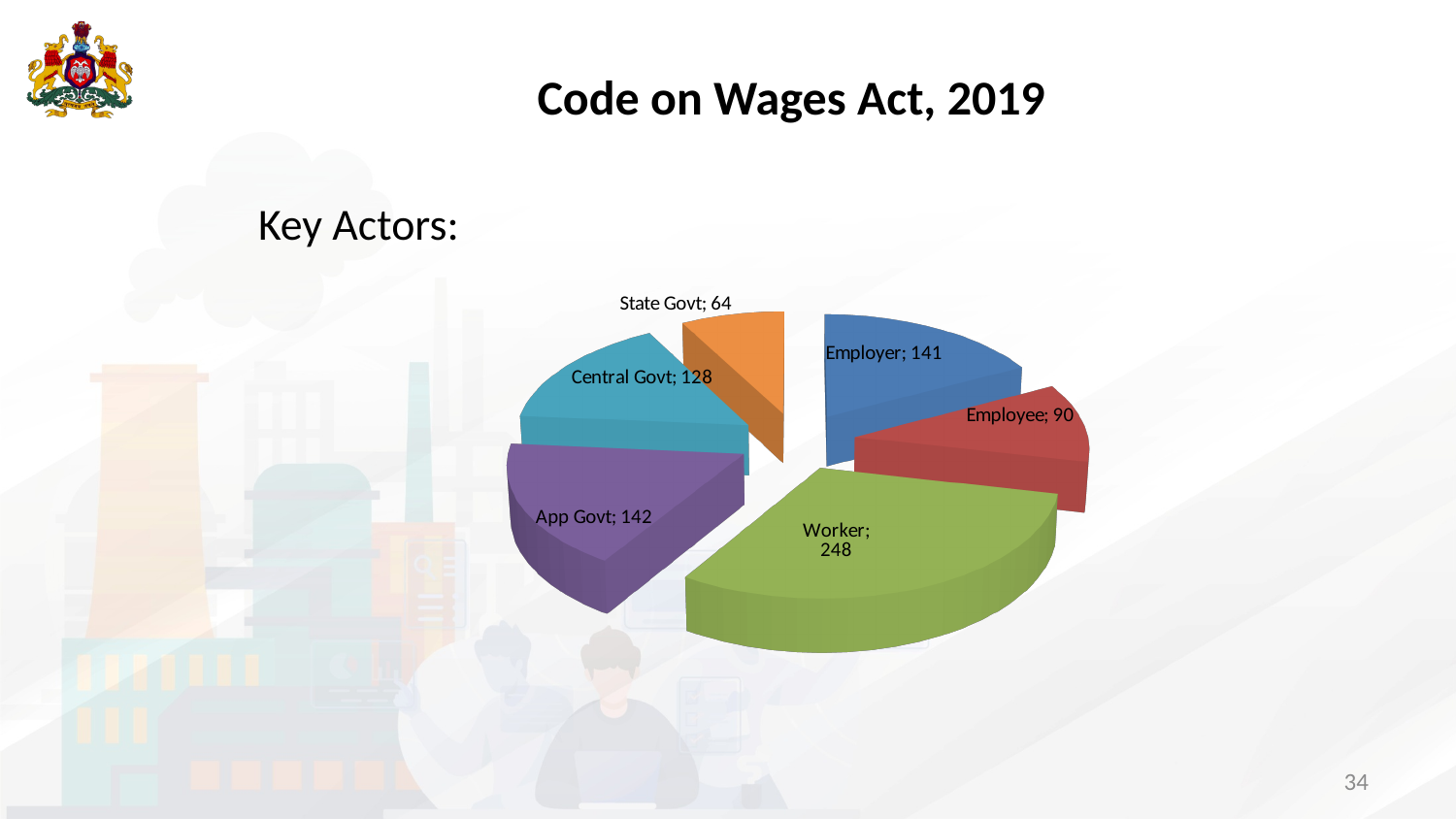
What is the value for Employee in the pie chart? 90 What is the total of all the values shown in the pie chart? 813 What is the value for State Govt in the pie chart? 64 What is the value for Worker in the pie chart? 248 Which category has the smallest slice in the pie chart? State Govt What kind of chart is shown on the slide? Pie chart What is the difference between the values for Worker and Employee? 158 How many categories are shown in the pie chart? 6 What is the difference between the values for Central Govt and State Govt? 64 What is the value for Central Govt in the pie chart? 128 Which is larger, the value for Employer or the value for Employee? Employer Which category has the largest slice in the pie chart? Worker